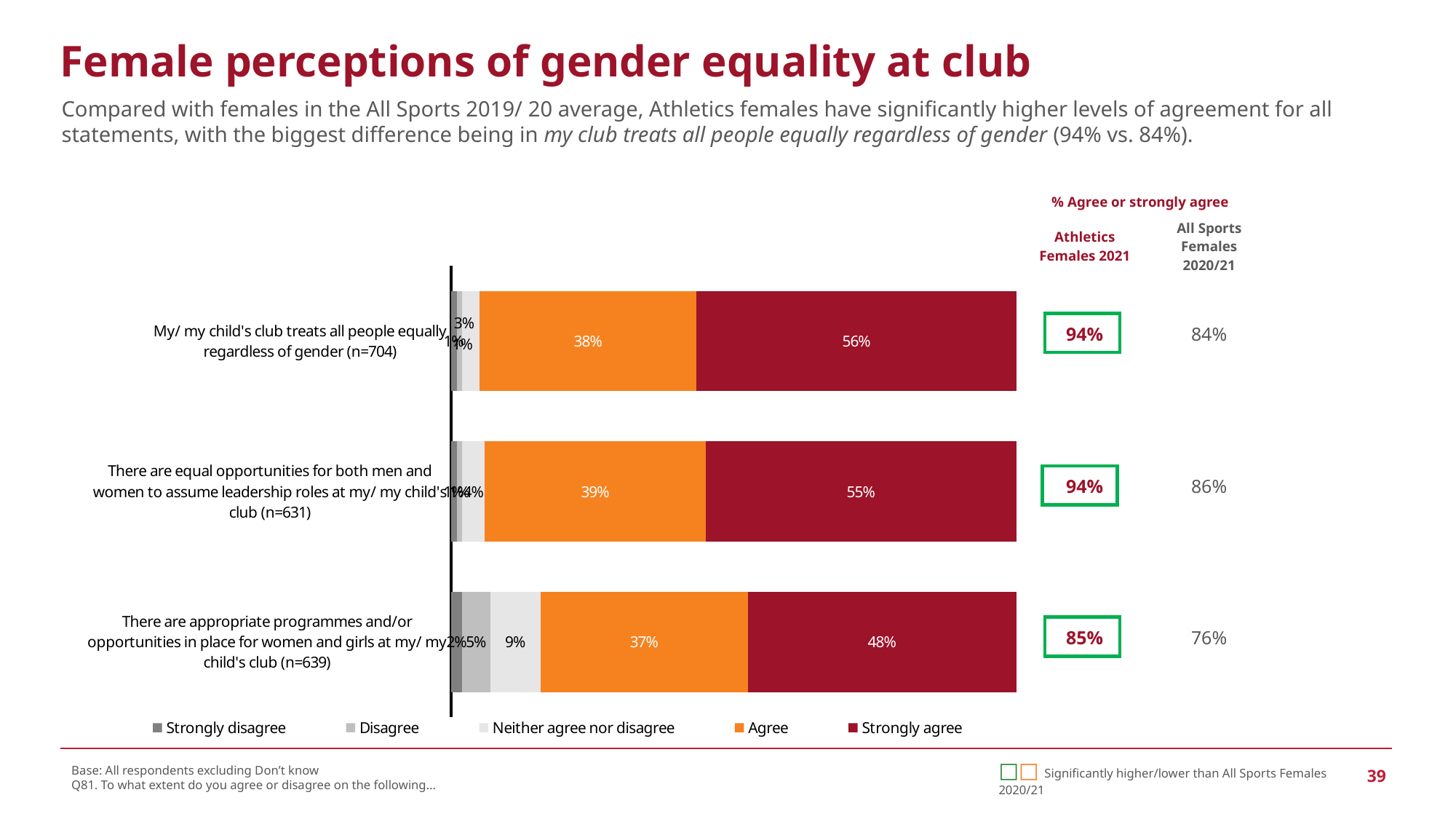
What percentage of respondents strongly agree that their/their child's club treats all people equally regardless of gender? 56% Which statement has the lowest 'Strongly agree' percentage? There are appropriate programmes and/or opportunities in place for women and girls at my/ my child's club (n=639) What percentage of respondents strongly agree that there are appropriate programmes and/or opportunities in place for women and girls at their/their child's club? 48% What percentage of respondents agree that there are equal opportunities for both men and women to assume leadership roles at their/their child's club? 39% What type of chart is used on this slide? Stacked horizontal bar chart Is the 'Strongly agree' percentage higher for the statement about equal leadership opportunities or for the statement about appropriate programmes for women and girls? Equal leadership opportunities (55% vs 48%) How many response categories does the legend list? 5 How many statements are shown in the chart? 3 What is the difference in 'Strongly agree' percentage between the statement about the club treating all people equally and the statement about appropriate programmes for women and girls? 8 percentage points What percentage of respondents neither agree nor disagree that there are appropriate programmes and/or opportunities in place for women and girls at their/their child's club? 9% Which statement has the highest 'Strongly agree' percentage? My/ my child's club treats all people equally regardless of gender (n=704) What is the '% Agree or strongly agree' figure for Athletics Females 2021 for the statement about appropriate programmes and/or opportunities for women and girls? 85%